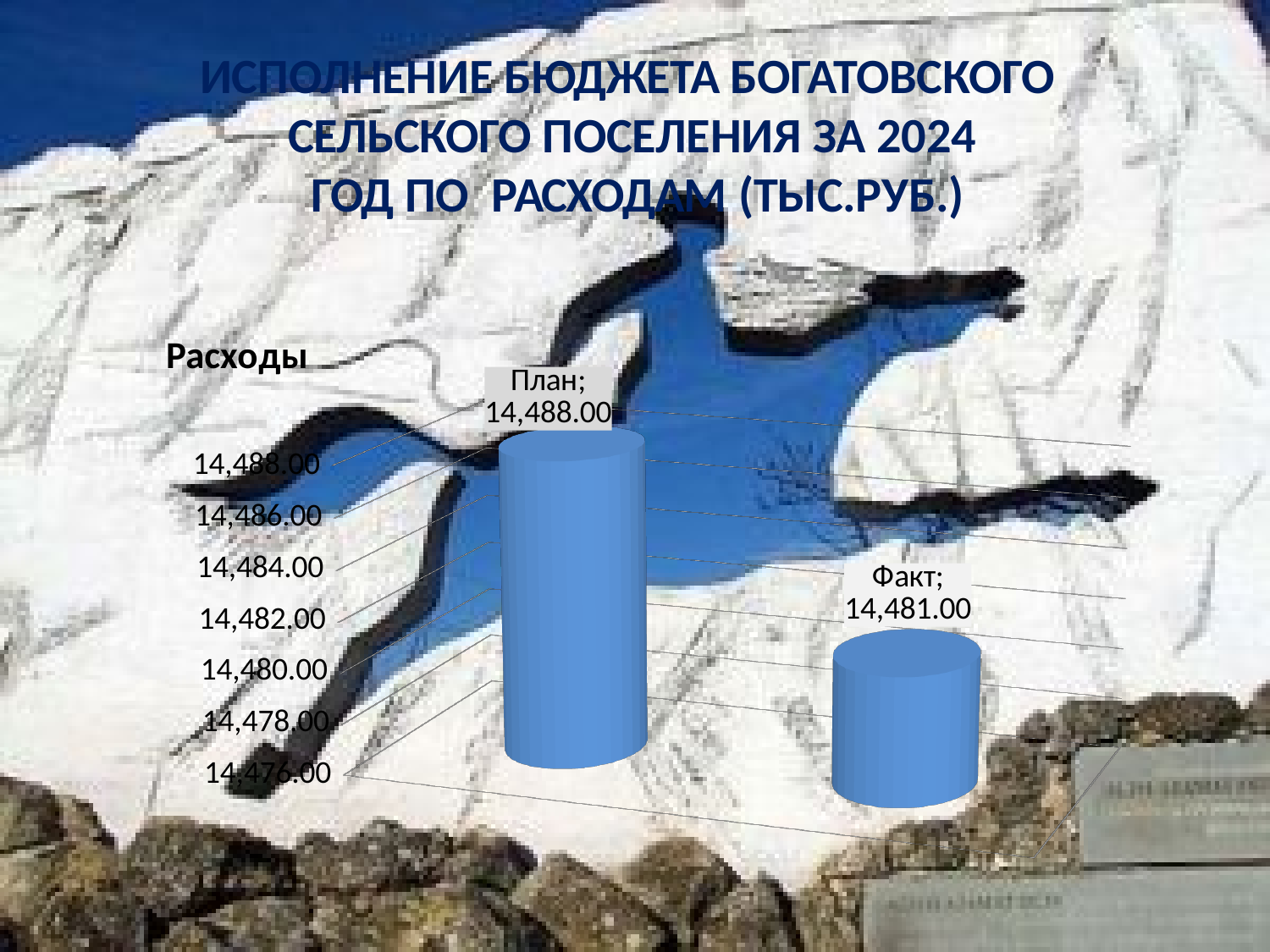
Which is larger in the Расходы chart, План or Факт? План What is the title of the chart on the slide? Расходы What is the value for Факт (Fact) in the Расходы chart? 14,481.00 Which category has the highest value in the Расходы chart? План What is the value for План (Plan) in the Расходы chart? 14,488.00 What is the difference between the План and Факт values in the Расходы chart? 7.00 What is the lowest value shown on the vertical axis of the Расходы chart? 14,476.00 How many categories are plotted in the Расходы chart? 2 Is the value for Факт greater or less than 14,484.00? less What kind of chart is shown on the slide? Bar chart Is the value for План greater or less than 14,486.00? greater Which category has the lowest value in the Расходы chart? Факт